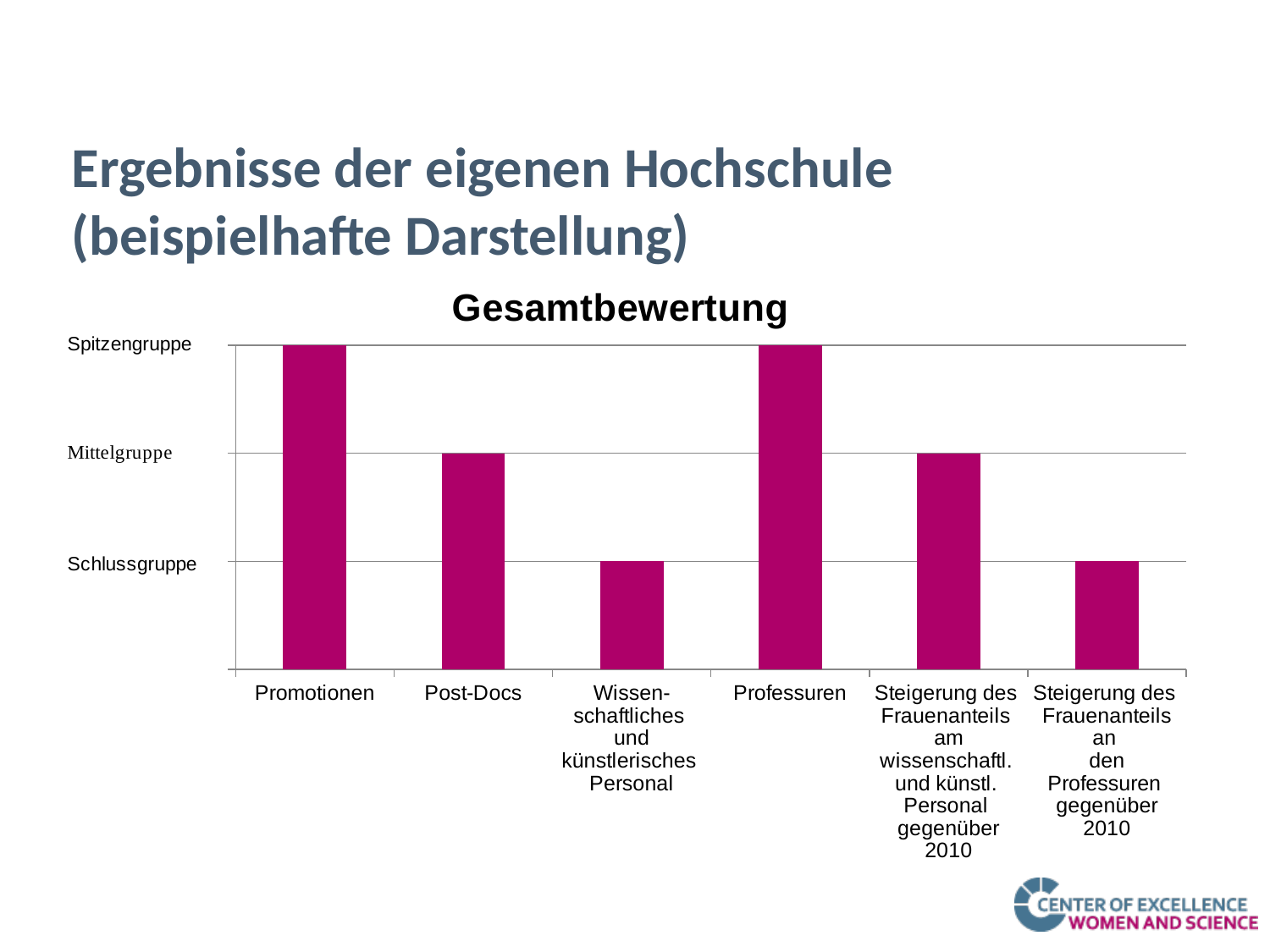
Which categories have the highest bars in the chart? Promotionen and Professuren Which rating group does the bar for Post-Docs reach? Mittelgruppe Which rating group does the bar for Professuren reach? Spitzengruppe What kind of chart is shown on the slide? bar chart How many categories are shown on the x axis of the chart? 6 Which bar is higher, Promotionen or Post-Docs? Promotionen Which rating group does the bar for Steigerung des Frauenanteils am wissenschaftl. und künstl. Personal gegenüber 2010 reach? Mittelgruppe Which rating group does the bar for Steigerung des Frauenanteils an den Professuren gegenüber 2010 reach? Schlussgruppe What is the title of the chart? Gesamtbewertung Which rating group does the bar for Promotionen reach? Spitzengruppe Which bar is higher, Professuren or Wissenschaftliches und künstlerisches Personal? Professuren Which rating group does the bar for Wissenschaftliches und künstlerisches Personal reach? Schlussgruppe